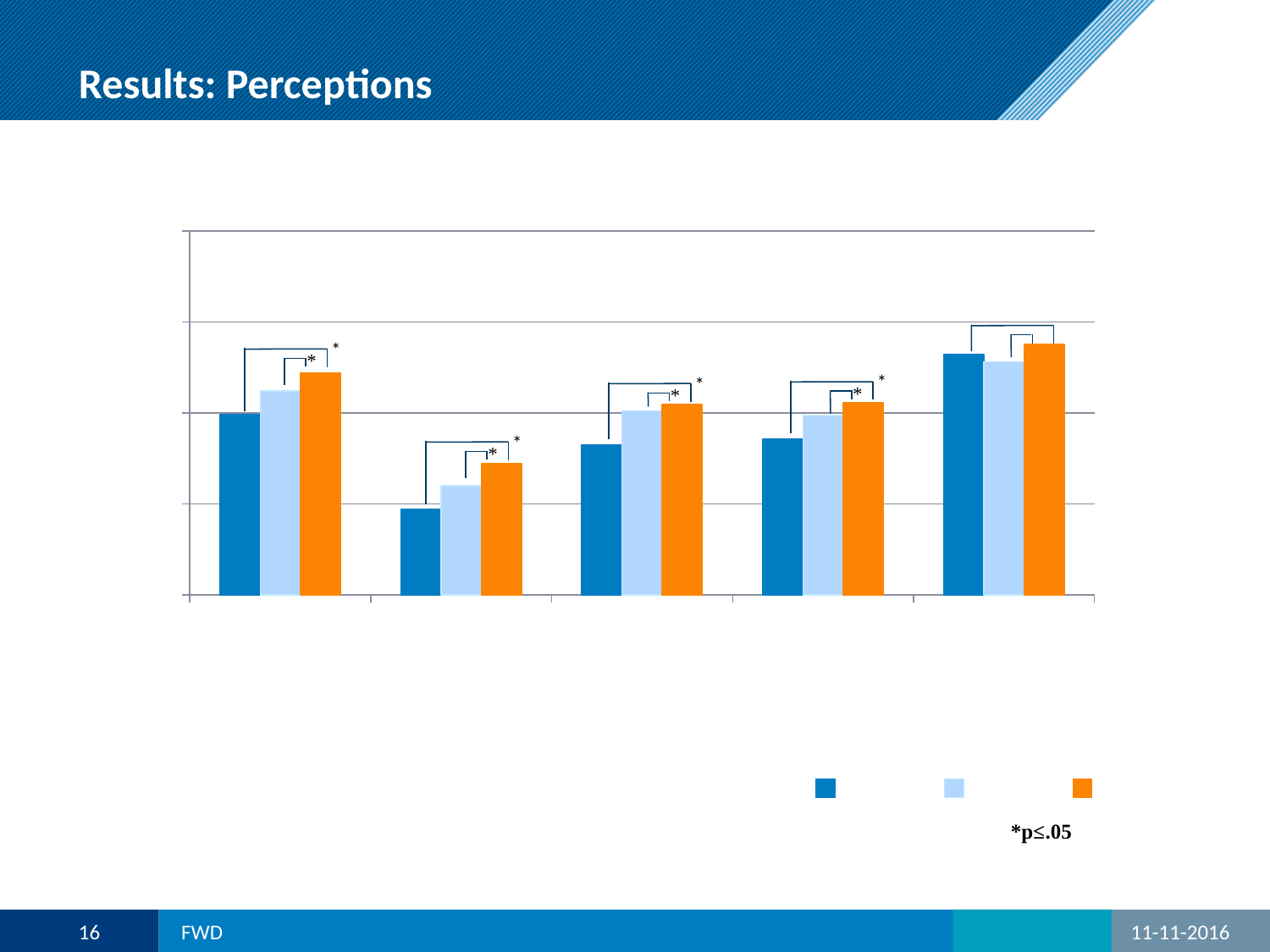
What kind of chart is shown on the slide? bar chart Which group of bars has the shortest bars overall? the second group from the left Which group of bars has the tallest bars overall: the leftmost group or the rightmost group? the rightmost group In the second group of bars from the left, is the dark blue bar taller or shorter than the light blue bar? shorter What colours are the three series in the chart? dark blue, light blue and orange How many groups of bars are plotted in the chart? 5 How many series does the legend show? 3 In the rightmost group of bars, is the light blue bar taller or shorter than the orange bar? shorter What is the title of the slide containing the chart? Results: Perceptions How many bars are in each group of the chart? 3